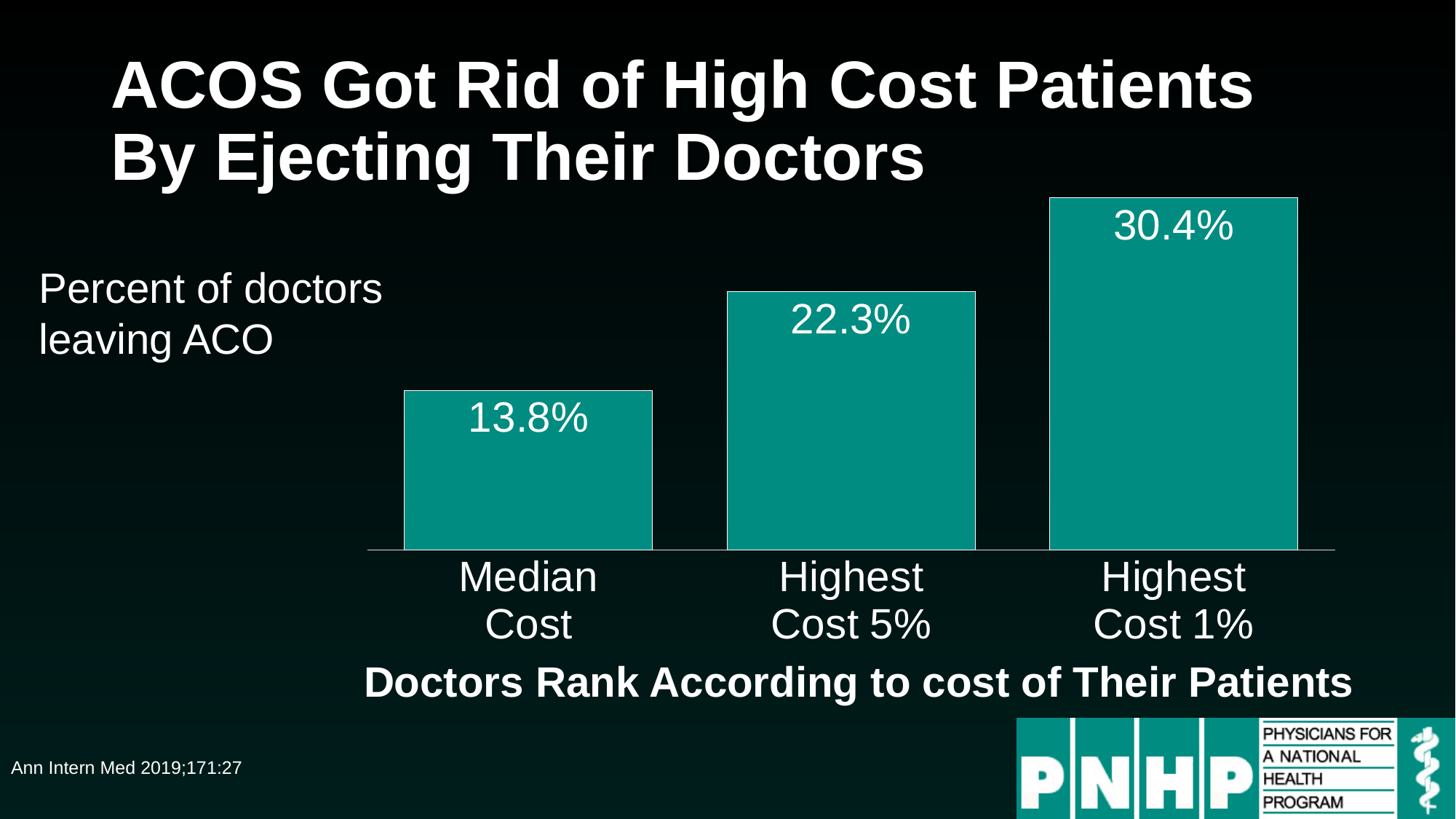
Do the values rise or fall moving from Median Cost to Highest Cost 1% along the x axis? Rise What is the x-axis title of the chart? Doctors Rank According to cost of Their Patients Which category has the lowest percent of doctors leaving the ACO? Median Cost What is the value for the Highest Cost 5% category? 22.3% What is the difference between the Highest Cost 5% and Median Cost values? 8.5% What is the difference between the Highest Cost 1% and Median Cost values? 16.6% Which is larger, the value for Highest Cost 5% or the value for Median Cost? Highest Cost 5% Which category has the highest percent of doctors leaving the ACO? Highest Cost 1% How many categories are shown on the x axis of the chart? 3 What is the value for the Highest Cost 1% category? 30.4% What kind of chart is shown on the slide? Bar chart What percent of doctors ranked at Median Cost left the ACO? 13.8%